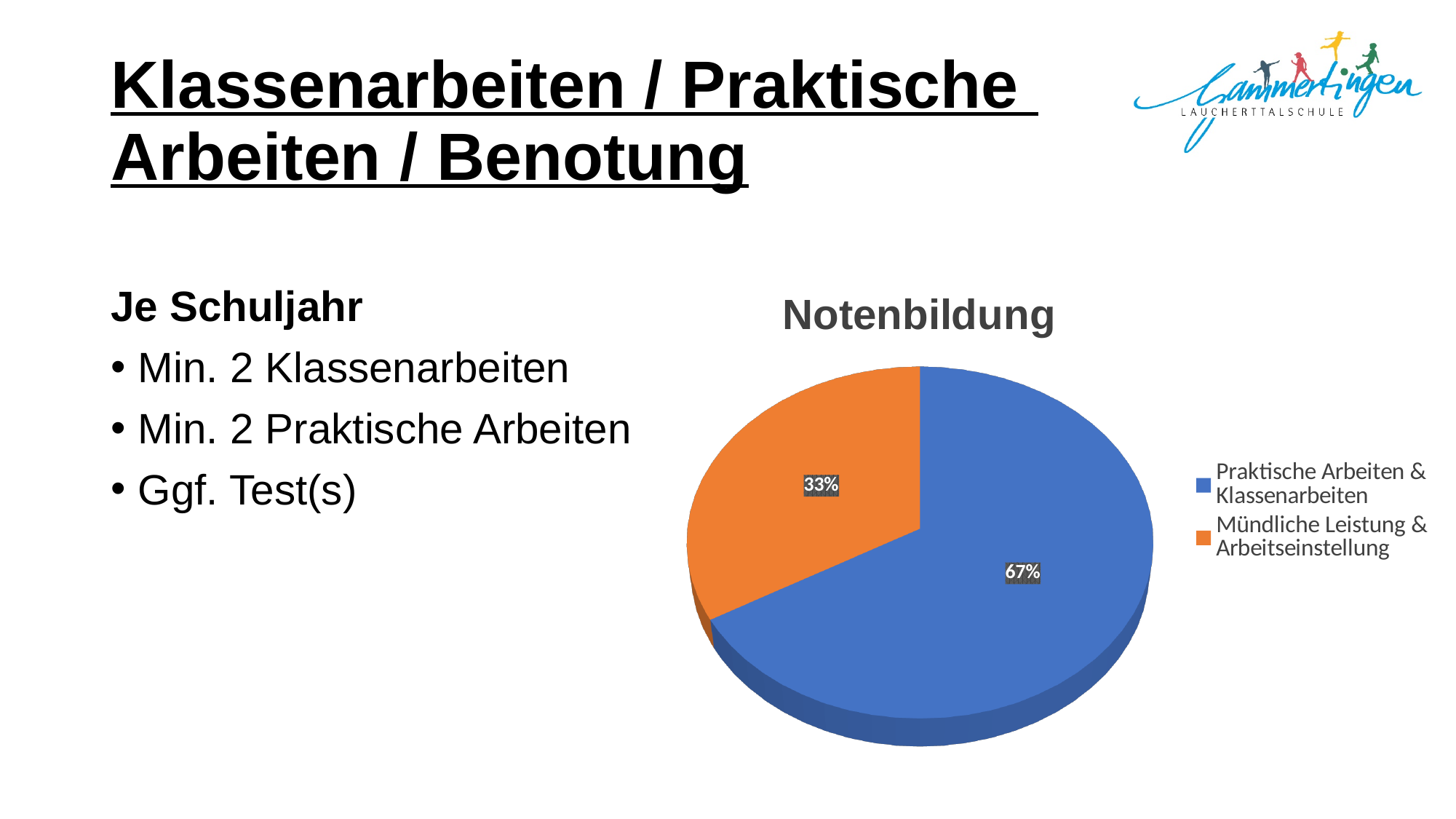
How many slices does the pie chart have? 2 How many entries does the legend list? 2 What is the title of the chart? Notenbildung What colour is the slice for "Mündliche Leistung & Arbeitseinstellung"? orange What is the difference in percentage points between the "Praktische Arbeiten & Klassenarbeiten" slice and the "Mündliche Leistung & Arbeitseinstellung" slice? 34 percentage points Which slice of the pie is the smallest? Mündliche Leistung & Arbeitseinstellung What share of the pie does "Mündliche Leistung & Arbeitseinstellung" take? 33% Which is larger: the share for "Praktische Arbeiten & Klassenarbeiten" or the share for "Mündliche Leistung & Arbeitseinstellung"? Praktische Arbeiten & Klassenarbeiten What kind of chart is shown on the slide? pie chart What share of the pie does "Praktische Arbeiten & Klassenarbeiten" take? 67% Which slice of the pie is the largest? Praktische Arbeiten & Klassenarbeiten